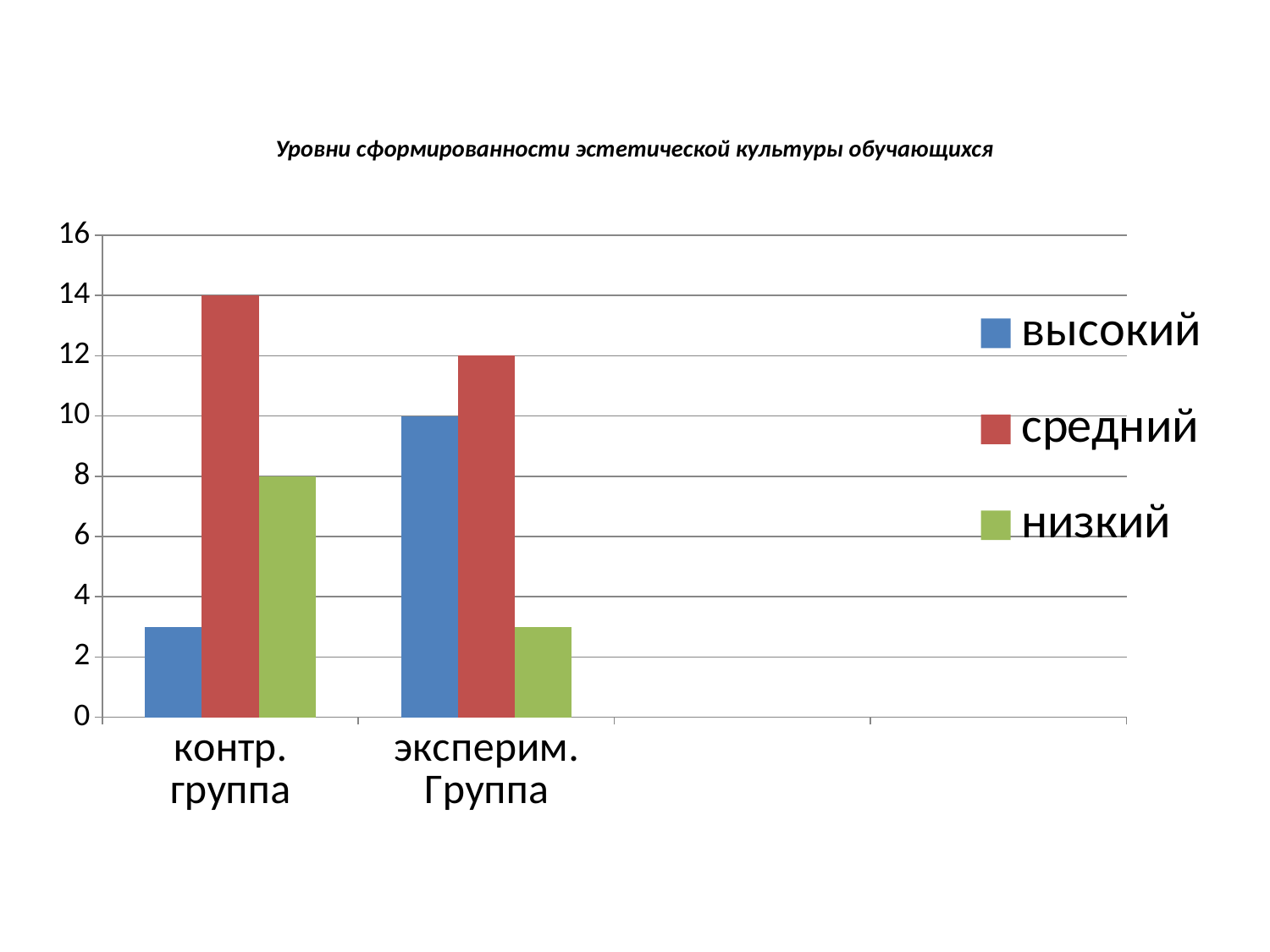
What is the value of низкий for контр. группа? 8 Is the value of высокий for контр. группа greater or less than 4? less What kind of chart is shown on the slide? bar chart How many groups (categories) are shown on the x axis? 2 What is the value of средний for контр. группа? 14 What is the value of средний for эксперим. Группа? 12 What is the difference between средний for контр. группа and средний for эксперим. Группа? 2 What is the value of высокий for эксперим. Группа? 10 Which series has the lowest value for эксперим. Группа? низкий How many series does the legend list? 3 Which is larger: высокий for контр. группа or высокий for эксперим. Группа? эксперим. Группа Which series has the highest value for контр. группа? средний